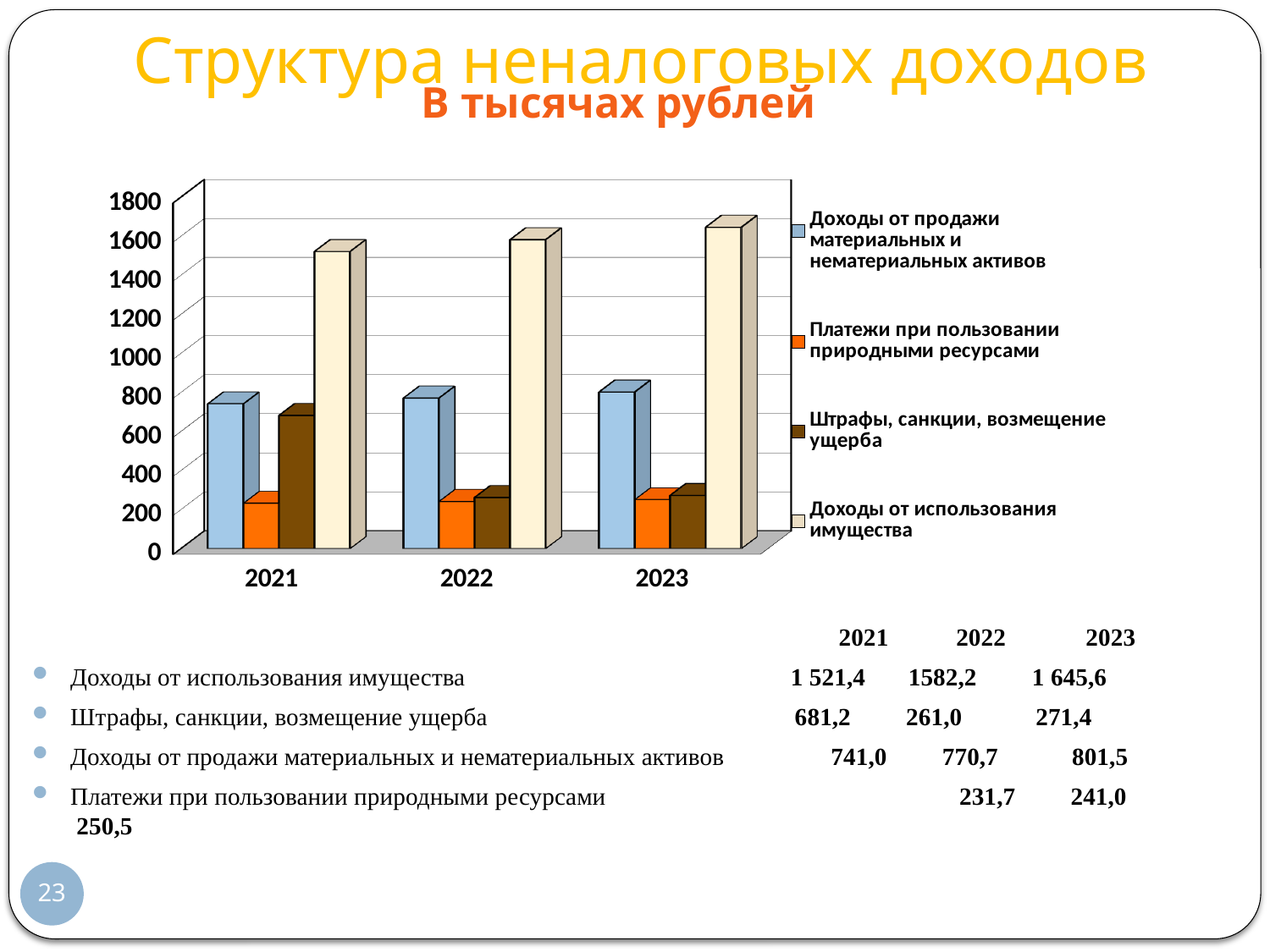
What kind of chart is shown on the slide? bar chart How many years are shown on the x axis of the chart? 3 In 2021, which is larger: Штрафы, санкции, возмещение ущерба or Доходы от продажи материальных и нематериальных активов? Доходы от продажи материальных и нематериальных активов What is the difference between Доходы от продажи материальных и нематериальных активов in 2023 and in 2021? 60,5 What is the title of the slide? Структура неналоговых доходов In which year is Доходы от использования имущества highest? 2023 What is the value of Доходы от использования имущества in 2023? 1 645,6 Do the values for Доходы от продажи материальных и нематериальных активов rise or fall from 2021 to 2023? rise What is the value of Штрафы, санкции, возмещение ущерба in 2021? 681,2 How many series does the chart legend list? 4 Which series has the highest value in 2022? Доходы от использования имущества Is the value for Доходы от использования имущества in 2021 greater or less than 1400? greater